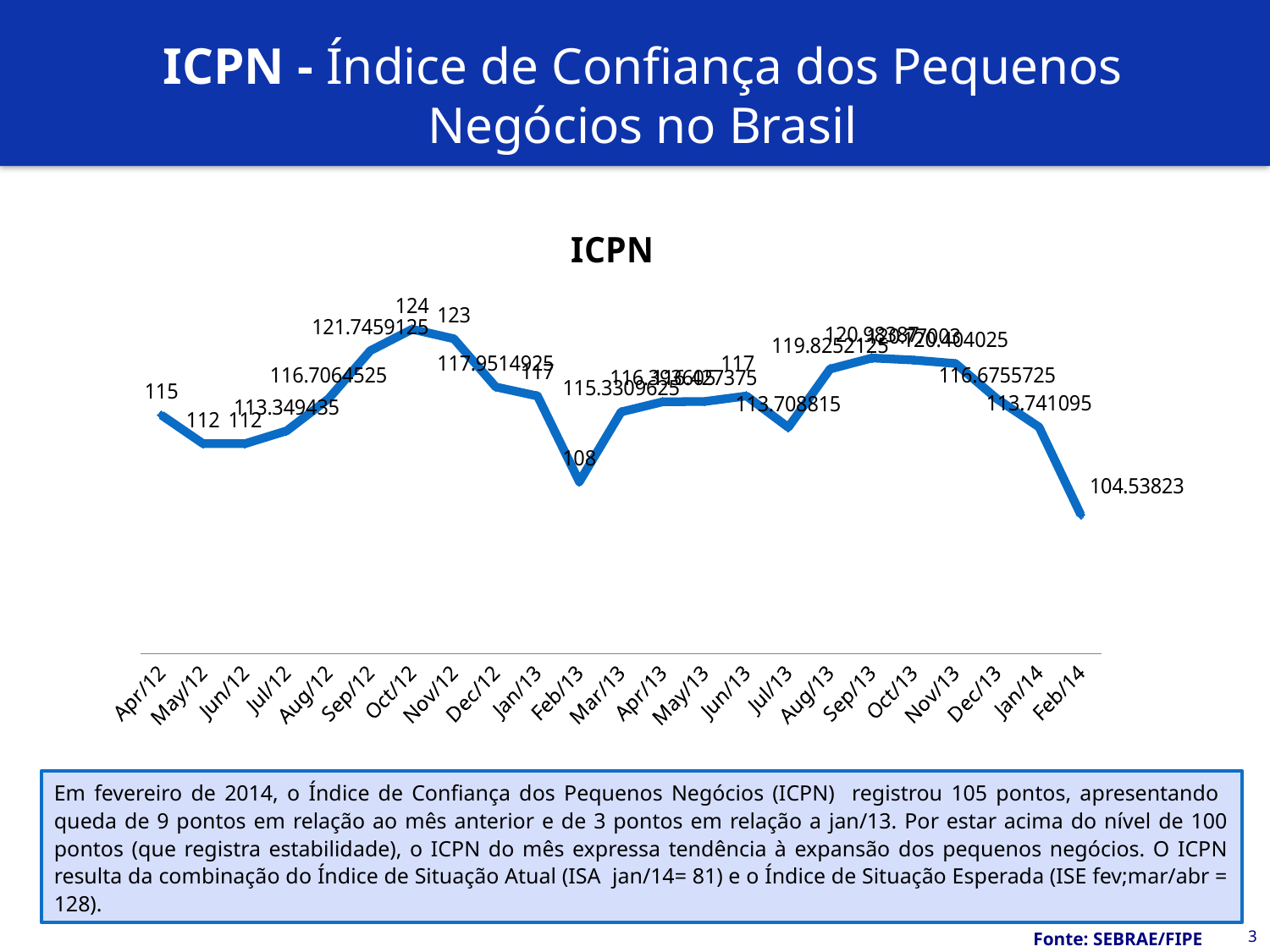
What is the ICPN value for Feb/13? 108 Which is larger, the ICPN value for Sep/12 or for Aug/13? Sep/12 What is the ICPN value for Feb/14? 104.53823 What is the ICPN value for Apr/12? 115 What is the ICPN value for Sep/12? 121.7459125 What is the title of the chart? ICPN How many months are plotted on the x axis? 23 Does the ICPN rise or fall from Dec/13 to Feb/14? fall Which month has the lowest ICPN value? Feb/14 What is the difference between the ICPN values for Oct/12 and Nov/12? 1 What kind of chart is shown on the slide? line chart Which month has the highest ICPN value? Oct/12